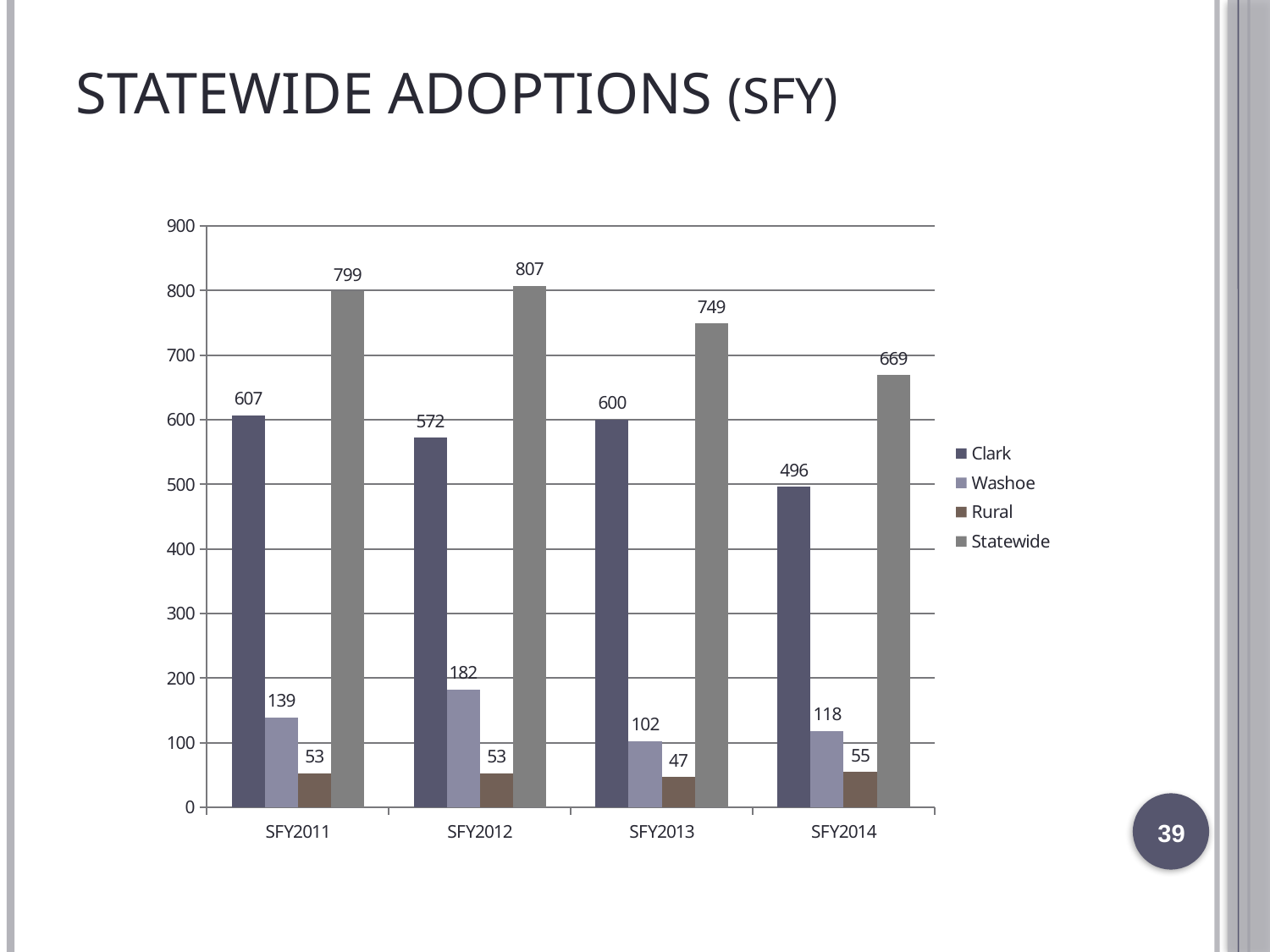
What is the Statewide value for SFY2012? 807 What is the difference between the Statewide values for SFY2012 and SFY2014? 138 In which year is the Clark value lowest? SFY2014 What is the Clark value for SFY2014? 496 Does the Statewide value rise or fall from SFY2012 to SFY2014? Fall In which year is the Statewide value highest? SFY2012 How many years are shown on the x axis? 4 How many series does the legend list? 4 What kind of chart is shown on the slide? Bar chart Which is larger, the Washoe value for SFY2012 or for SFY2013? SFY2012 What is the Washoe value for SFY2011? 139 What is the Rural value for SFY2013? 47